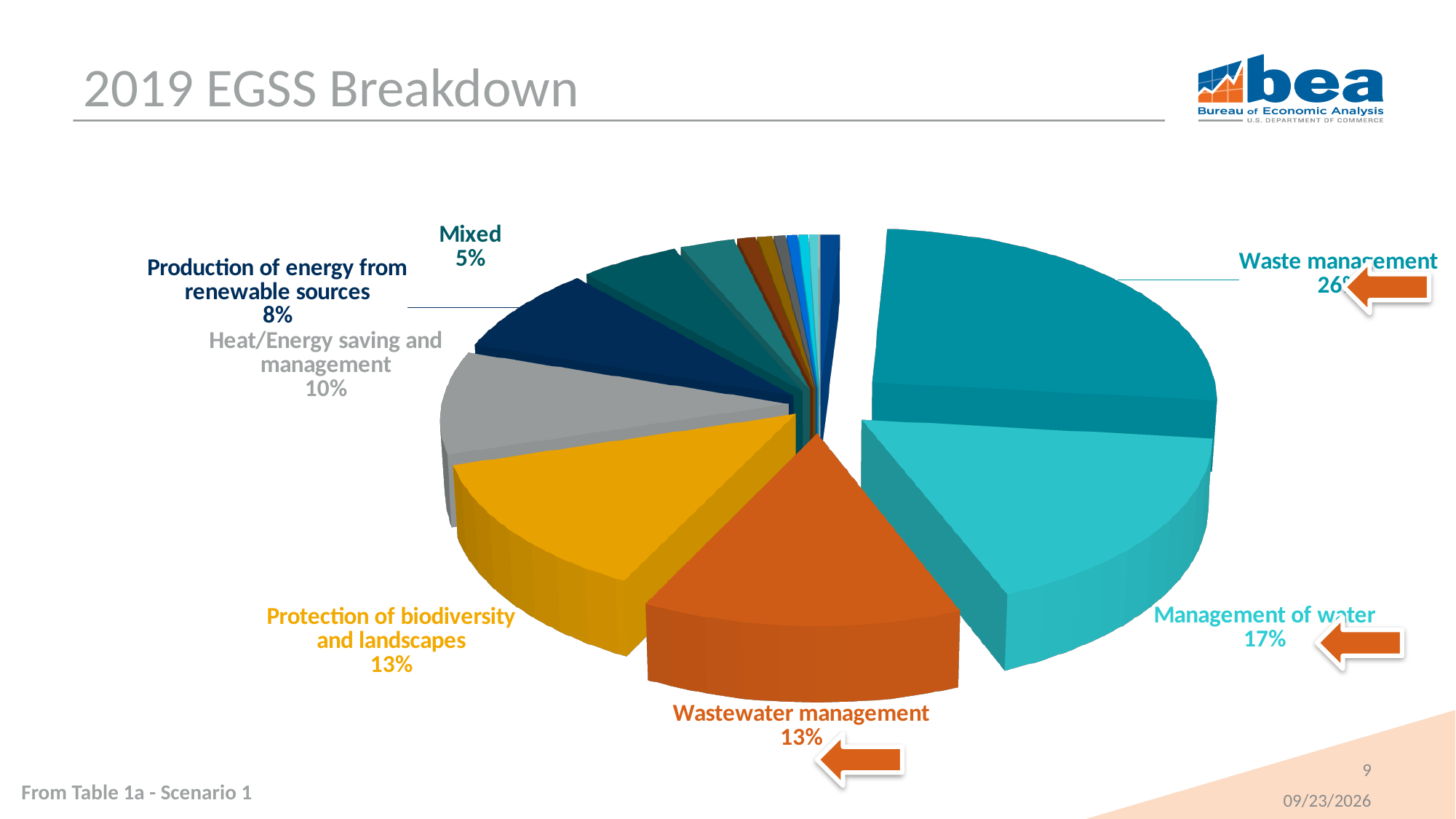
Which is larger, Management of water or Heat/Energy saving and management? Management of water What share of the pie does Management of water represent? 17% Which category has the largest slice of the pie? Waste management What is the title of the slide? 2019 EGSS Breakdown How many percentage points larger is Production of energy from renewable sources than Mixed? 3 percentage points What kind of chart is shown on the slide? pie chart What percentage is shown for Wastewater management? 13% What percentage is shown for Protection of biodiversity and landscapes? 13% What percentage is shown for Production of energy from renewable sources? 8% What percentage is shown for the Mixed category? 5% What percentage is shown for Heat/Energy saving and management? 10% How many percentage points larger is Management of water than Heat/Energy saving and management? 7 percentage points